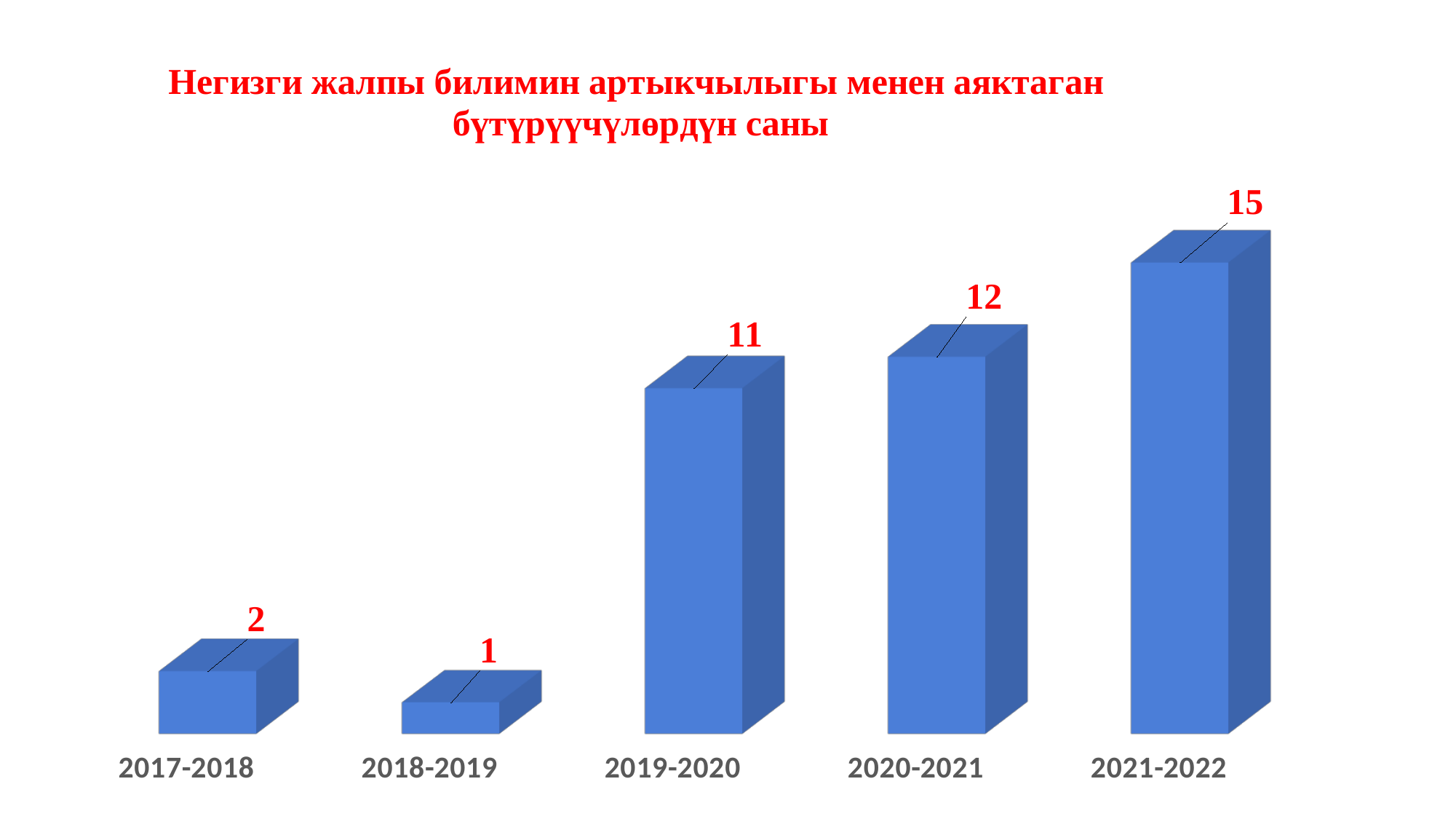
What is the value for 2019-2020? 11 Which year has the highest value? 2021-2022 Which is larger, the value for 2018-2019 or the value for 2020-2021? 2020-2021 What is the difference between the values for 2021-2022 and 2020-2021? 3 Which year has the lowest value? 2018-2019 What kind of chart is this? bar chart What colour are the bars? blue What is the difference between the values for 2019-2020 and 2017-2018? 9 What is the value for 2021-2022? 15 Do the values generally rise or fall from 2018-2019 to 2021-2022? rise What is the value for 2017-2018? 2 How many categories are shown on the x axis? 5